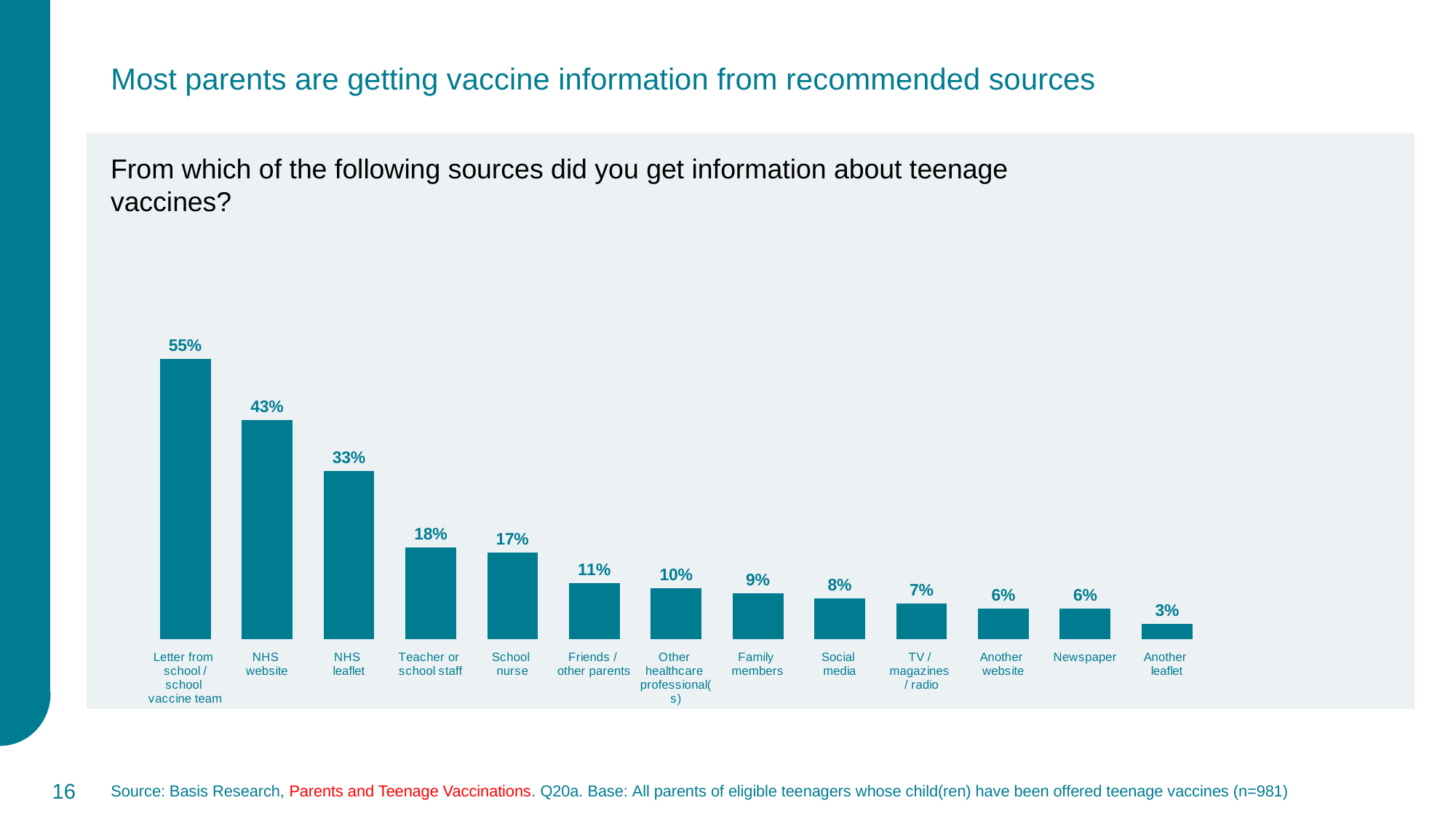
Which source has the highest percentage? Letter from school / school vaccine team What kind of chart is shown on the slide? Bar chart How many sources (bars) are shown in the chart? 13 What question is the chart based on, as shown in the chart heading? From which of the following sources did you get information about teenage vaccines? Do the values rise or fall moving from left to right across the chart? Fall Which source has the lowest percentage? Another leaflet Which is larger, the value for Family members or the value for TV / magazines / radio? Family members What is the value shown for School nurse? 17% What is the difference in percentage points between Letter from school / school vaccine team and NHS leaflet? 22 What is the difference in percentage points between Teacher or school staff and Friends / other parents? 7 What percentage of parents got information about teenage vaccines from the NHS website? 43% What percentage of parents got information from Social media? 8%